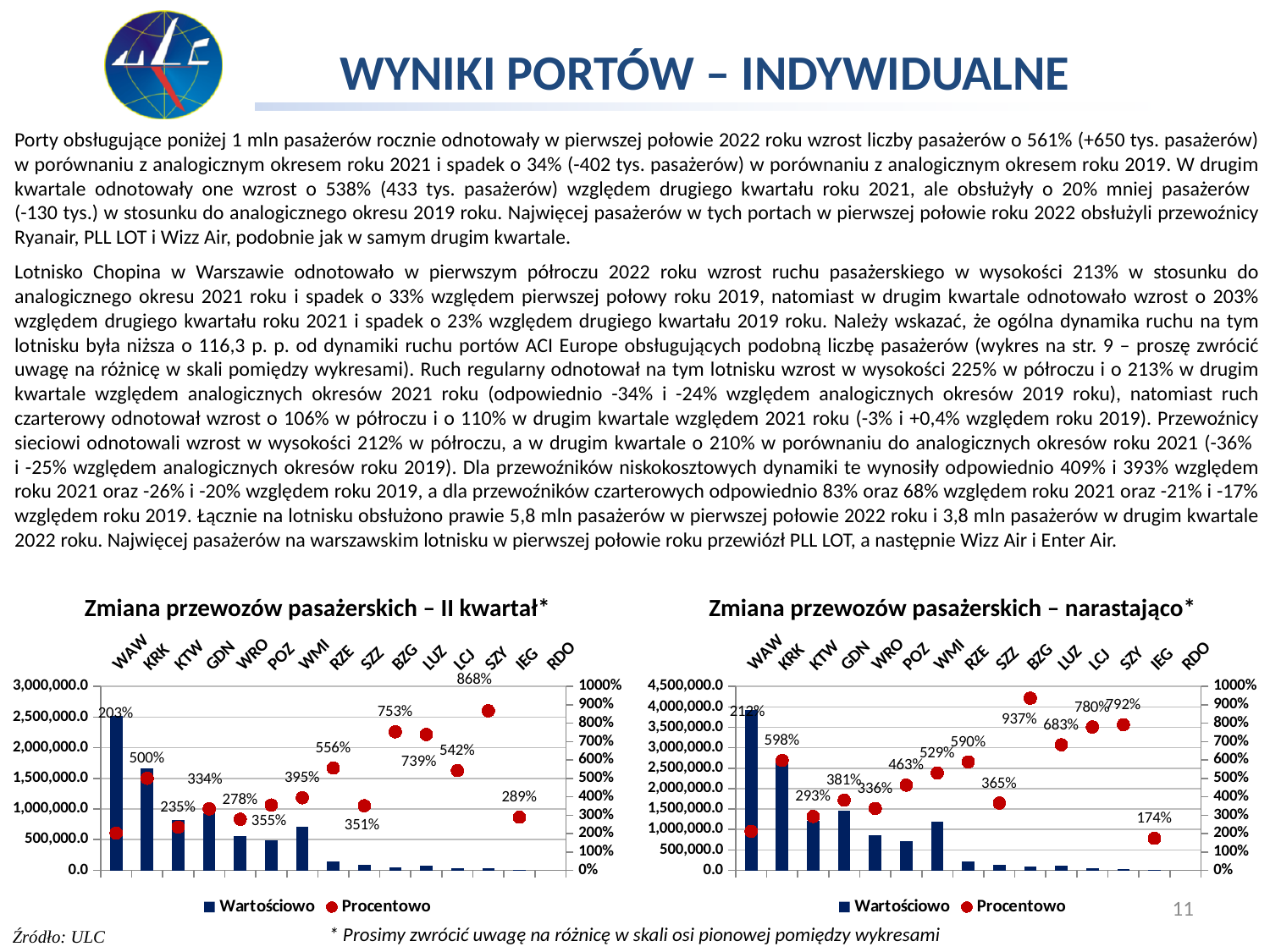
In the chart 'Zmiana przewozów pasażerskich – II kwartał*', what is the Procentowo value for BZG? 753% In the chart 'Zmiana przewozów pasażerskich – narastająco*', which airport has the highest Procentowo value? BZG In the chart 'Zmiana przewozów pasażerskich – narastająco*', which airport has the lowest labelled Procentowo value? IEG In the chart 'Zmiana przewozów pasażerskich – narastająco*', what is the Procentowo value for WAW? 212% How many series does the legend of the chart 'Zmiana przewozów pasażerskich – narastająco*' list? 2 In the chart 'Zmiana przewozów pasażerskich – narastająco*', is the Wartościowo bar for WAW greater or less than 3,500,000.0? greater In the chart 'Zmiana przewozów pasażerskich – II kwartał*', which airport has the highest Procentowo value? SZY In the chart 'Zmiana przewozów pasażerskich – II kwartał*', which airport has the lowest labelled Procentowo value? WAW In the chart 'Zmiana przewozów pasażerskich – II kwartał*', is the Wartościowo bar for WAW greater or less than 2,000,000.0? greater In the chart 'Zmiana przewozów pasażerskich – II kwartał*', what is the Procentowo value for KRK? 500% In the chart 'Zmiana przewozów pasażerskich – II kwartał*', what is the difference between the Procentowo values for BZG and LUZ? 14 percentage points In the chart 'Zmiana przewozów pasażerskich – narastająco*', which is larger, the Procentowo value for KRK or for RZE? KRK